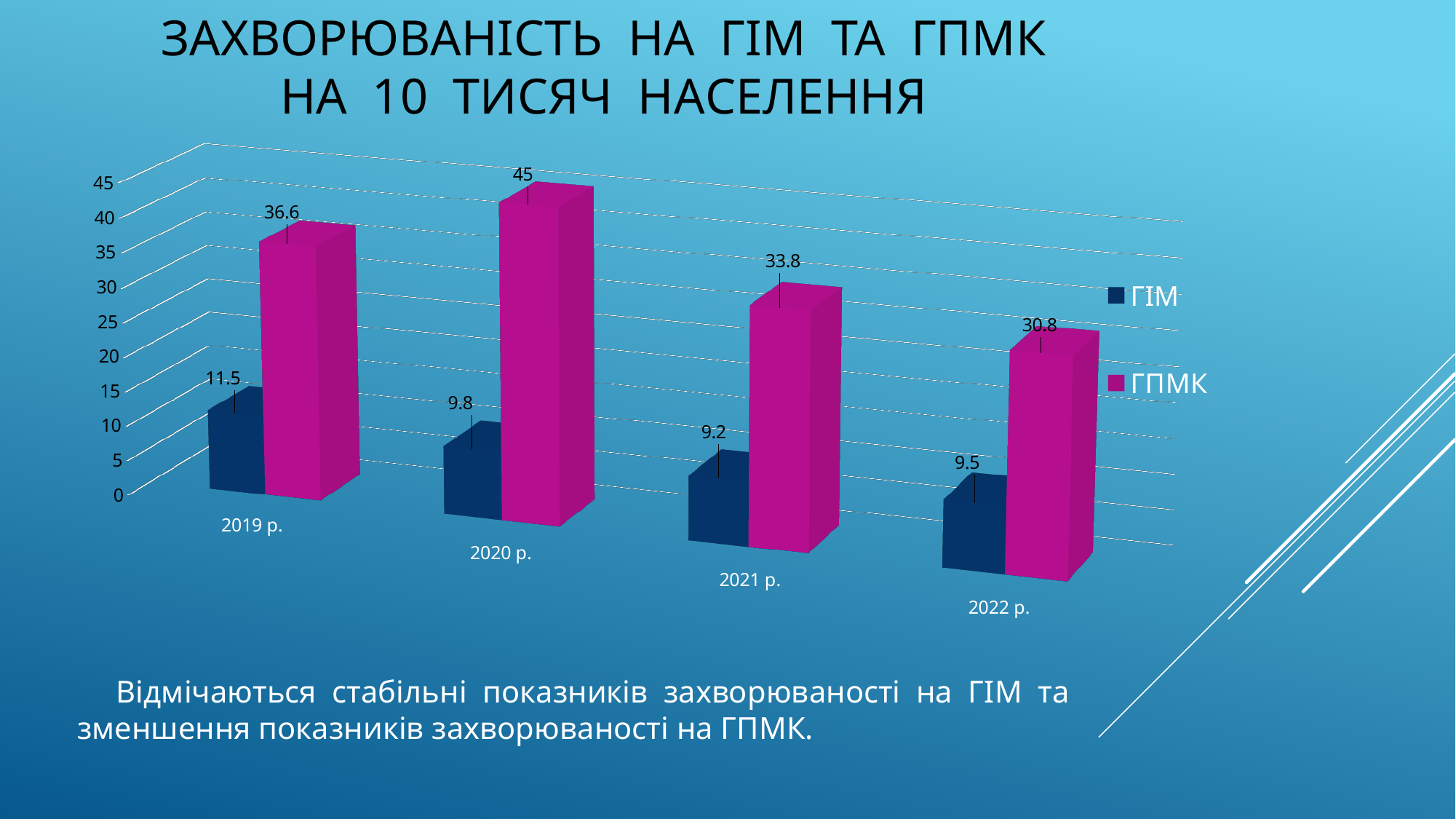
Which is larger, the ГІМ value for 2019 р. or for 2022 р.? 2019 р. What kind of chart is shown on the slide? bar chart What is the value for ГПМК in 2022 р.? 30.8 Does the ГПМК value rise or fall from 2020 р. to 2022 р.? fall In which year is the ГПМК value highest? 2020 р. Is the ГПМК value for 2021 р. greater or less than 30? greater What is the value for ГПМК in 2020 р.? 45 In which year is the ГІМ value lowest? 2021 р. How many series does the legend list? 2 What is the difference between the ГПМК values for 2020 р. and 2022 р.? 14.2 How many years are shown on the x axis? 4 What is the value for ГІМ in 2019 р.? 11.5